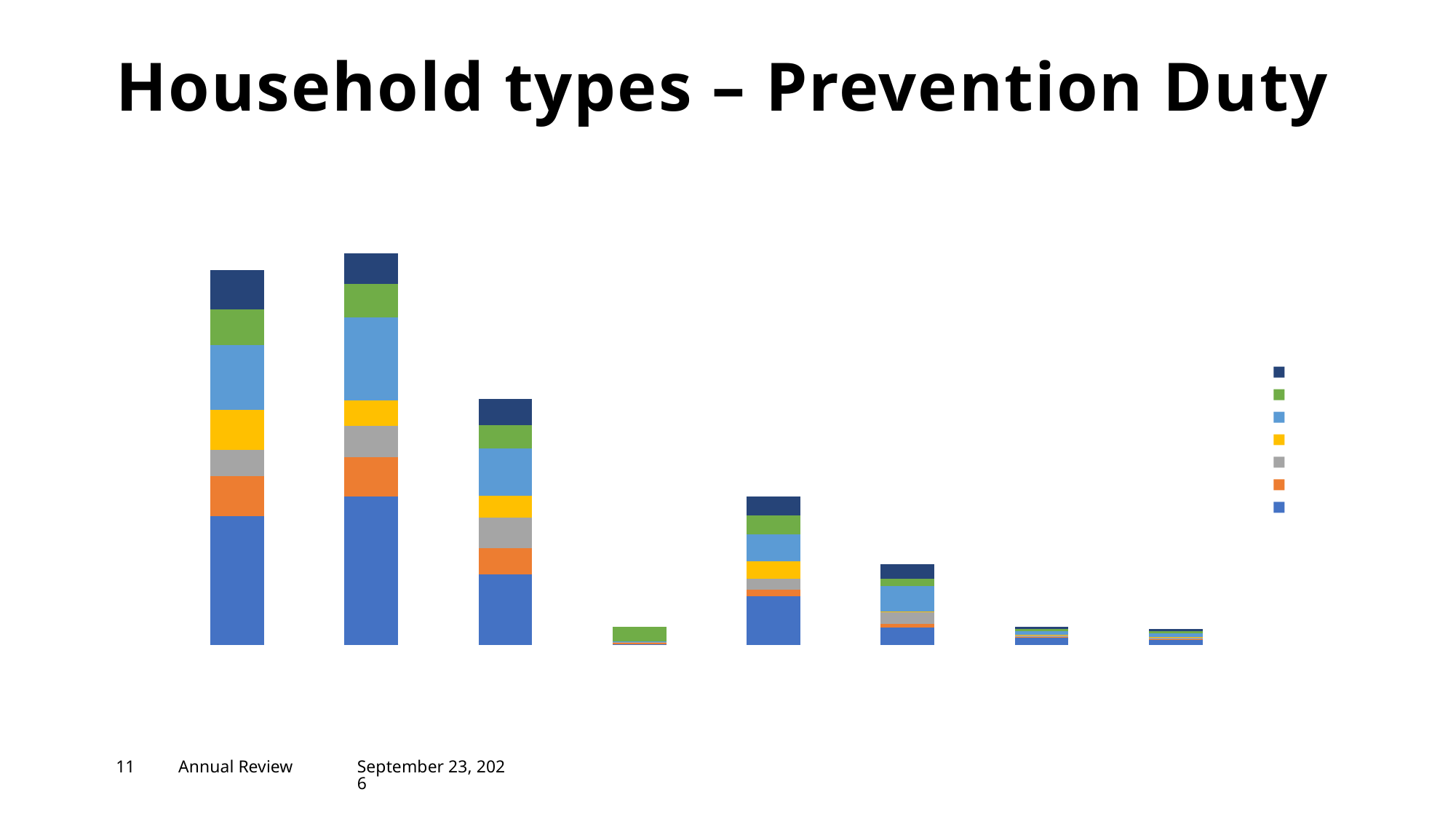
Which is taller, the first bar from the left or the second bar from the left? the second bar What kind of chart is shown on the slide? stacked bar chart Which is taller, the third bar from the left or the fifth bar from the left? the third bar Which is taller, the fifth bar from the left or the sixth bar from the left? the fifth bar Which bar is the tallest in the chart, counting from the left? the second bar How many series does the legend list? 7 What colour is the bottom segment of the stacked bars? blue How many bars (categories) are plotted in the chart? 8 What is the title shown above the chart on the slide? Household types – Prevention Duty